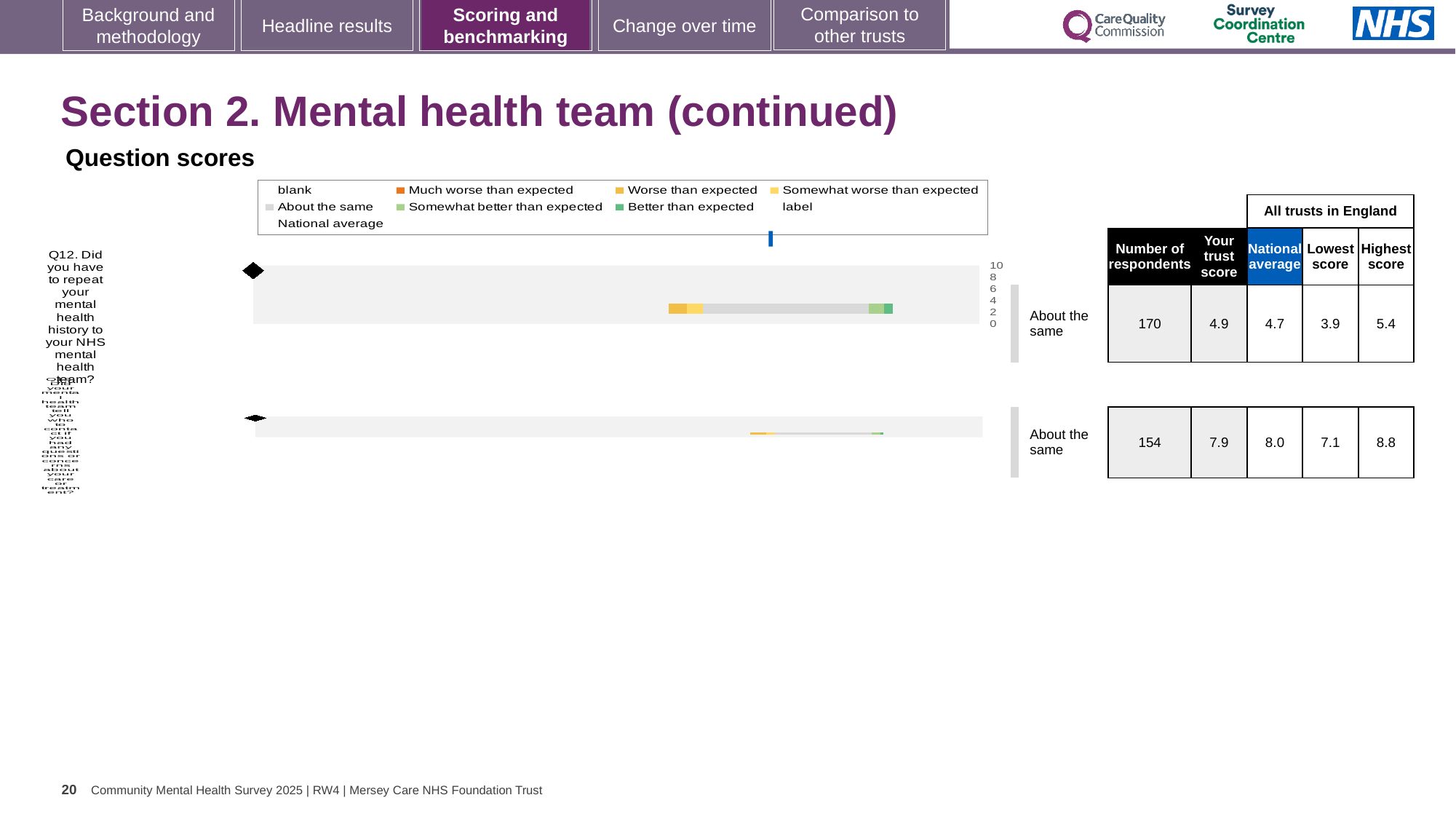
What kind of chart is used to show the question scores on this slide? Bar chart For Q12, which is larger: the trust's score or the national average? Your trust score In the chart for Q12, what is the national average score? 4.7 In the legend, what colour represents 'Much worse than expected'? Orange How many respondents are listed for Q12? 170 For Q12, what is the highest score among all trusts in England? 5.4 In the lower (second) chart on the slide, which is larger: the trust's score or the national average? National average In the chart for Q12 (repeating your mental health history), what is the trust's score shown in the 'Your trust score' column? 4.9 For Q12, what is the difference between the highest score and the lowest score across all trusts in England? 1.5 In the lower (second) chart on the slide, what is the trust's score? 7.9 In the lower (second) chart on the slide, what is the difference between the highest score (8.8) and the lowest score (7.1)? 1.7 What benchmark category is shown next to the Q12 chart? About the same